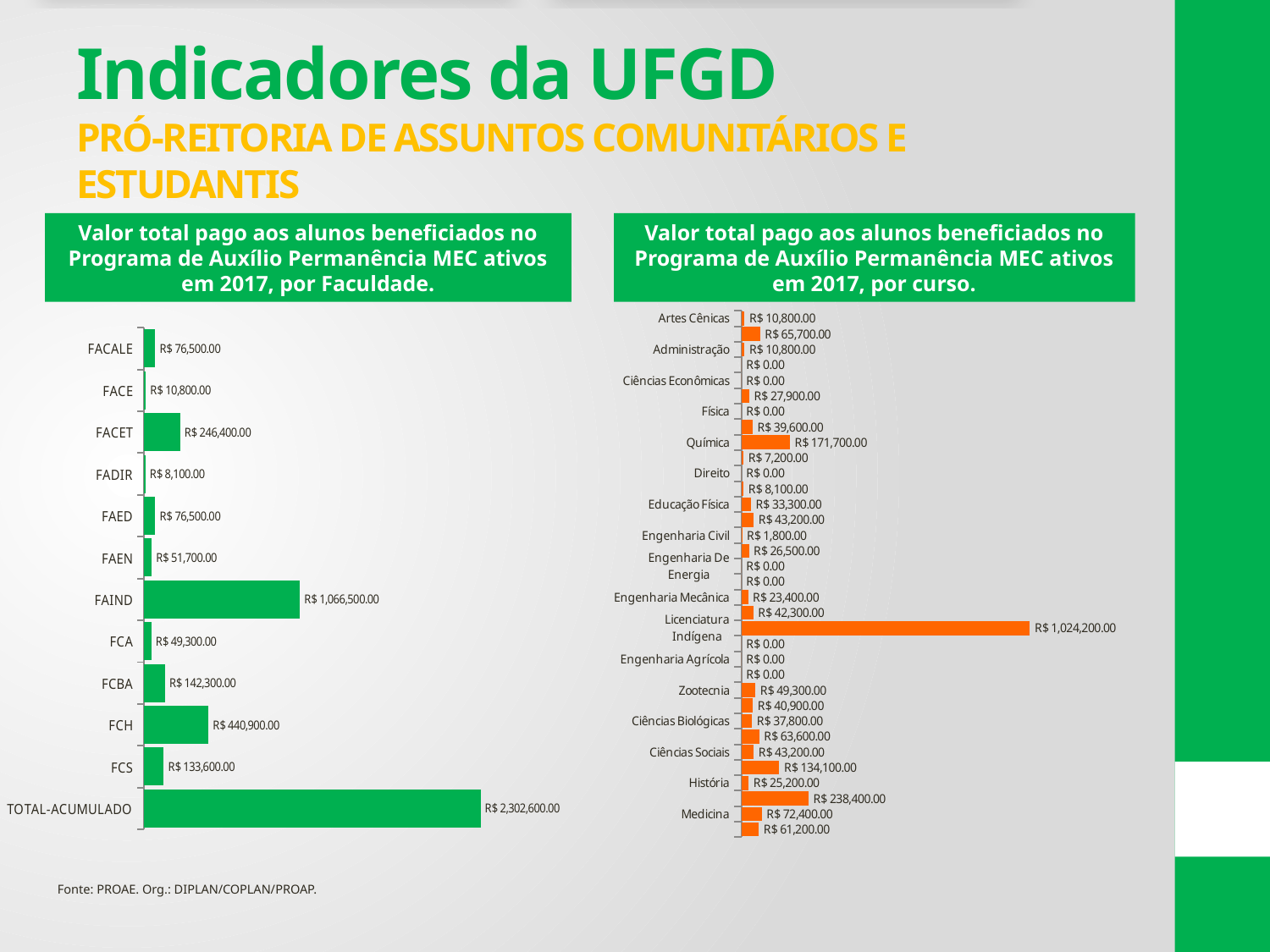
How many bars are shown in the chart 'por Faculdade' on the left? 12 In the chart 'por Faculdade' on the left, what is the value for FACET? R$ 246,400.00 In the chart 'por Faculdade' on the left, which category has the lowest value? FADIR What colour are the bars in the chart 'por curso' on the right? Orange In the chart 'por curso' on the right, what is the value of the longest bar, labelled Licenciatura Indígena? R$ 1,024,200.00 In the chart 'por Faculdade' on the left, what is the value for TOTAL-ACUMULADO? R$ 2,302,600.00 In the chart 'por Faculdade' on the left, which is larger, the value for FAEN or the value for FCA? FAEN In the chart 'por Faculdade' on the left, what is the difference between the values for FCBA and FCS? R$ 8,700.00 In the chart 'por Faculdade' on the left, what is the difference between the values for FAIND and FCH? R$ 625,600.00 In the chart 'por Faculdade' on the left, what is the value for FCH? R$ 440,900.00 What kind of chart is the chart 'por Faculdade' on the left? Bar chart In the chart 'por Faculdade' on the left, which faculty (excluding TOTAL-ACUMULADO) has the highest value? FAIND